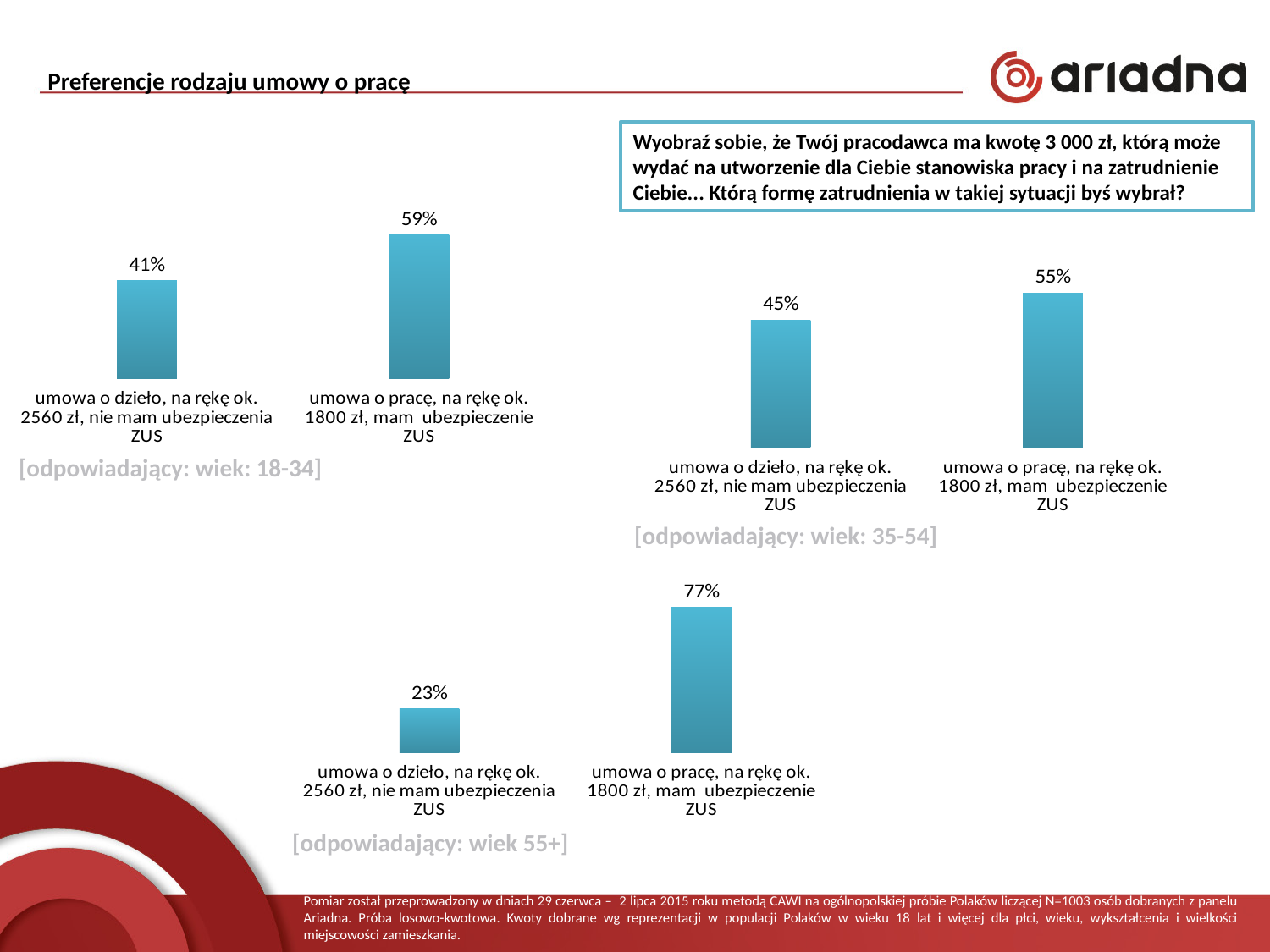
In the chart for respondents aged 55+, what percentage chose 'umowa o pracę, na rękę ok. 1800 zł, mam ubezpieczenie ZUS'? 77% In the chart for respondents aged 18-34, which option has the lowest value? umowa o dzieło, na rękę ok. 2560 zł, nie mam ubezpieczenia ZUS In the chart for respondents aged 18-34, what percentage chose 'umowa o pracę, na rękę ok. 1800 zł, mam ubezpieczenie ZUS'? 59% In the chart for respondents aged 55+, what percentage chose 'umowa o dzieło, na rękę ok. 2560 zł, nie mam ubezpieczenia ZUS'? 23% In the chart for respondents aged 18-34, what percentage chose 'umowa o dzieło, na rękę ok. 2560 zł, nie mam ubezpieczenia ZUS'? 41% How many categories are shown in the chart for respondents aged 35-54? 2 In the chart for respondents aged 55+, what is the difference between the value for 'umowa o pracę' and the value for 'umowa o dzieło'? 54% In the chart for respondents aged 35-54, which is larger: the value for 'umowa o dzieło' or the value for 'umowa o pracę'? umowa o pracę, na rękę ok. 1800 zł, mam ubezpieczenie ZUS In the chart for respondents aged 35-54, what percentage chose 'umowa o pracę, na rękę ok. 1800 zł, mam ubezpieczenie ZUS'? 55% In the chart for respondents aged 35-54, what percentage chose 'umowa o dzieło, na rękę ok. 2560 zł, nie mam ubezpieczenia ZUS'? 45% In the chart for respondents aged 55+, which option has the highest value? umowa o pracę, na rękę ok. 1800 zł, mam ubezpieczenie ZUS What type of chart is used for the respondents aged 18-34? bar chart